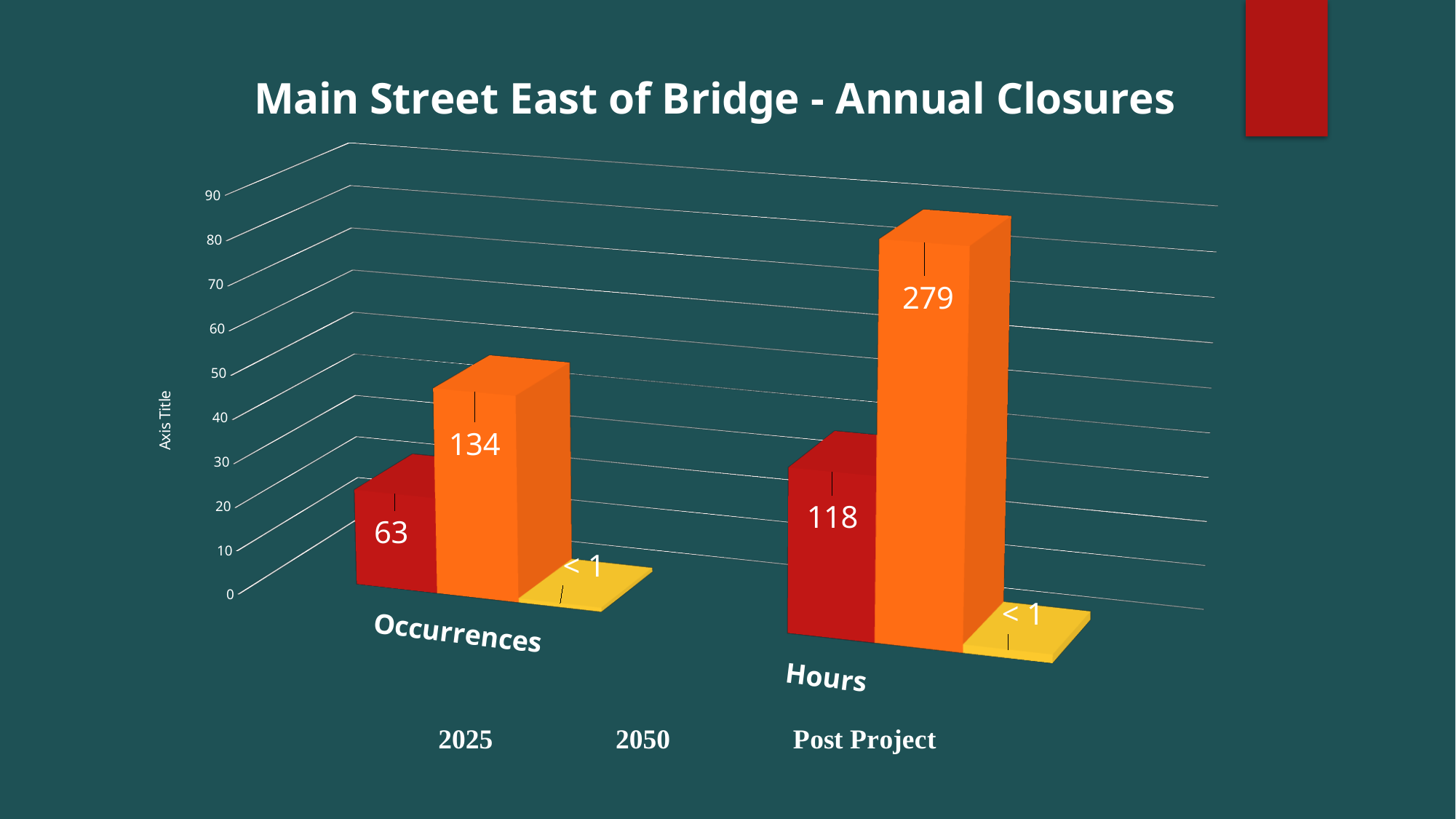
What is the title of the chart? Main Street East of Bridge - Annual Closures What is the 2025 value for Occurrences? 63 What is the 2025 value for Hours? 118 How many categories are shown on the x axis? 2 What is the Post Project value for Hours? < 1 What kind of chart is shown on the slide? bar chart Which series has the lowest value for Occurrences? Post Project What is the 2050 value for Occurrences? 134 What is the 2050 value for Hours? 279 How many series does the legend list? 3 What is the difference between the 2050 and 2025 values for Hours? 161 Which series has the highest value for Hours? 2050